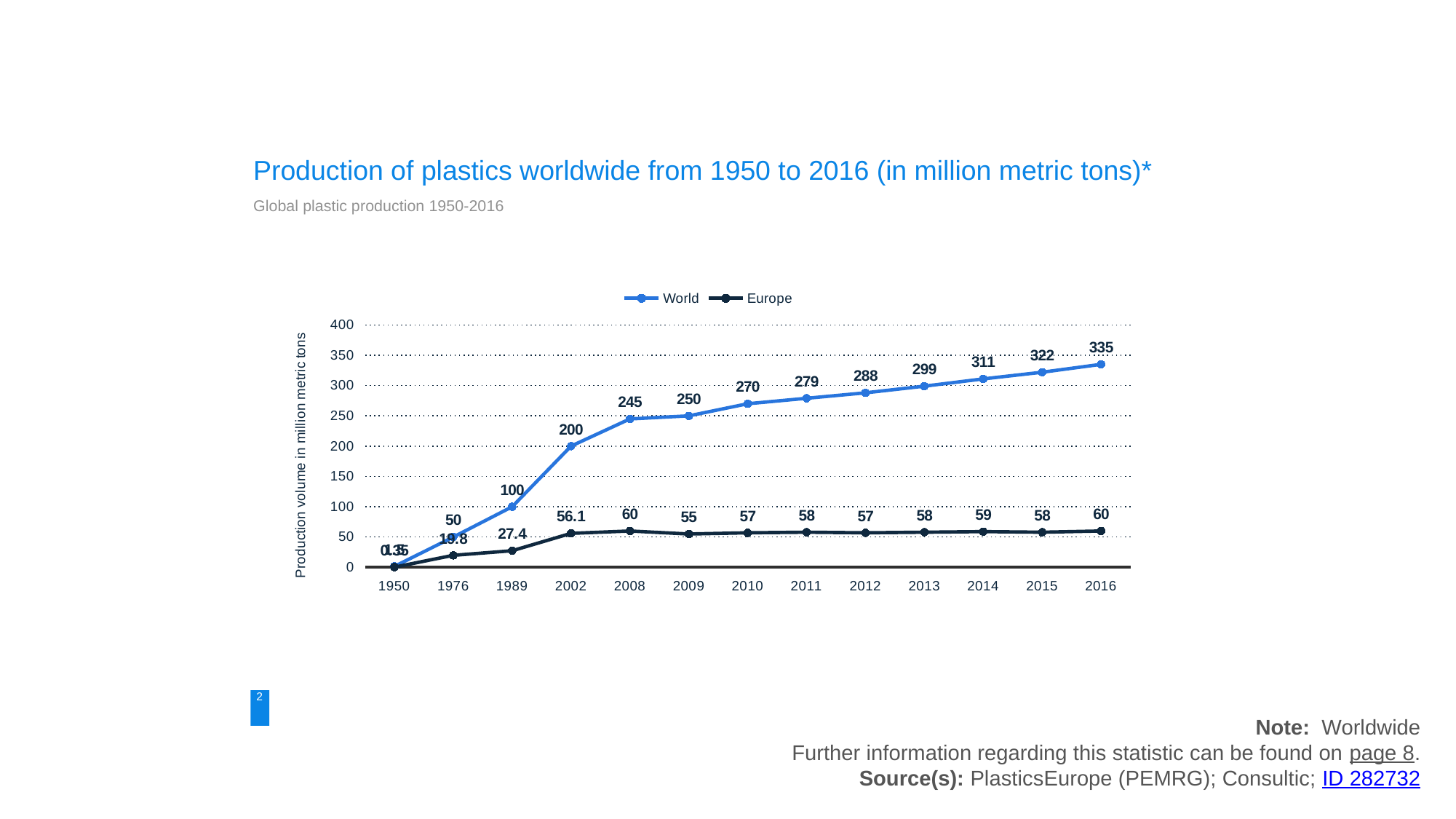
What is the difference between World and Europe production in 2010? 213 In which year was World plastic production highest? 2016 What was the Europe plastic production in 1976? 19.8 How many years are shown on the x axis? 13 Which series had the larger value in 2012, World or Europe? World What was the Europe plastic production in 2002? 56.1 Does World plastic production rise or fall from 1976 to 2016? rise How many series does the legend list? 2 What was the World plastic production in 2008? 245 What was the World plastic production in 2016? 335 What is the difference between World production in 2016 and 2015? 13 What type of chart is shown on the slide? line chart